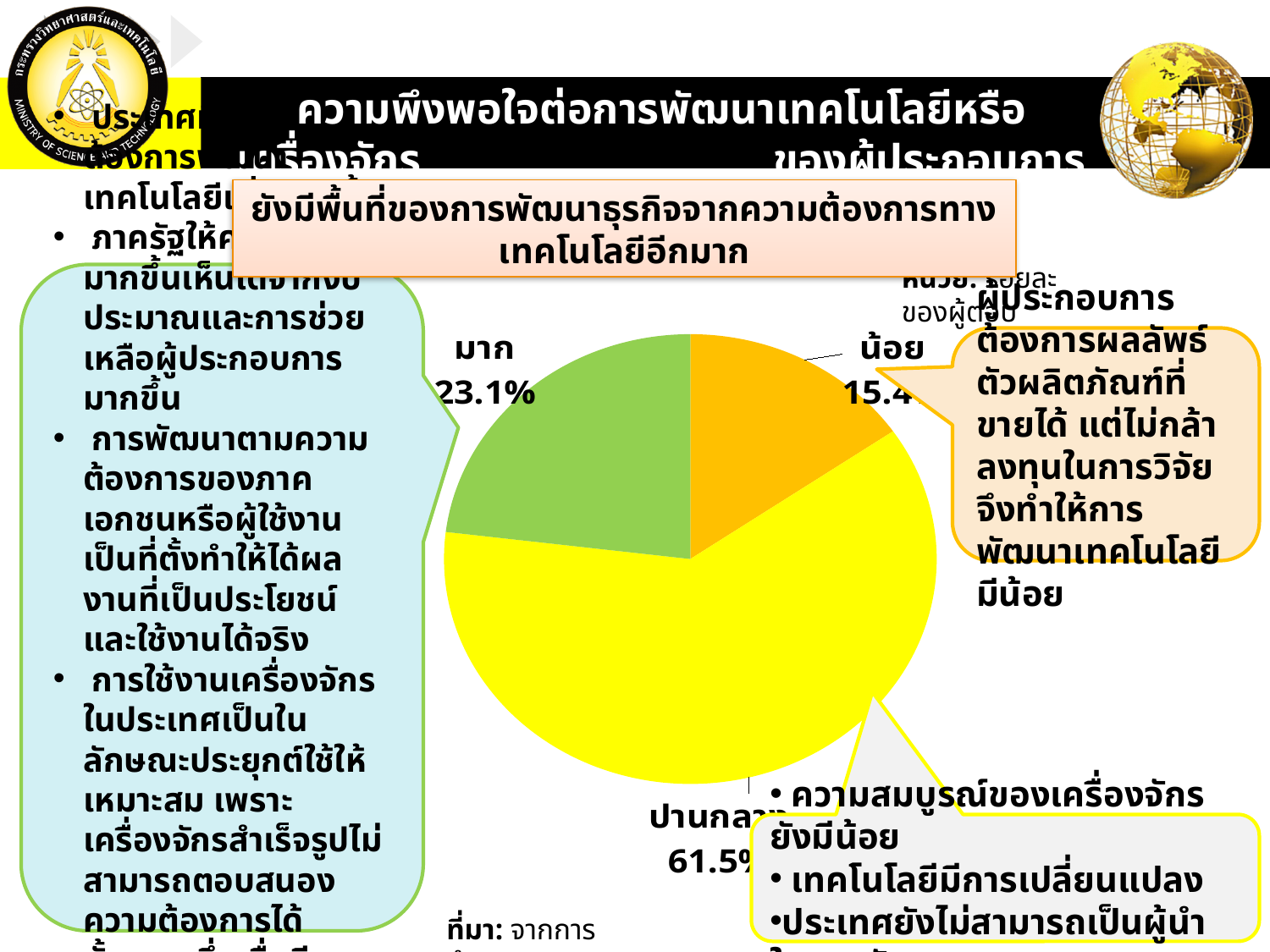
What percentage is shown for the category มาก? 23.1% How many slices does the pie chart have? 3 What percentage is shown for the category ปานกลาง? 61.5% Which is larger, the share for มาก or the share for น้อย? มาก Which category has the largest share of the pie chart? ปานกลาง What kind of chart is shown on the slide? pie chart Which category has the smallest share of the pie chart? น้อย Is the share for ปานกลาง greater or less than half of the pie? greater What is the difference between the share for ปานกลาง and the share for มาก? 38.4% What percentage is shown for the category น้อย? 15.4% What colour is the slice for ปานกลาง? yellow What is the difference between the share for มาก and the share for น้อย? 7.7%